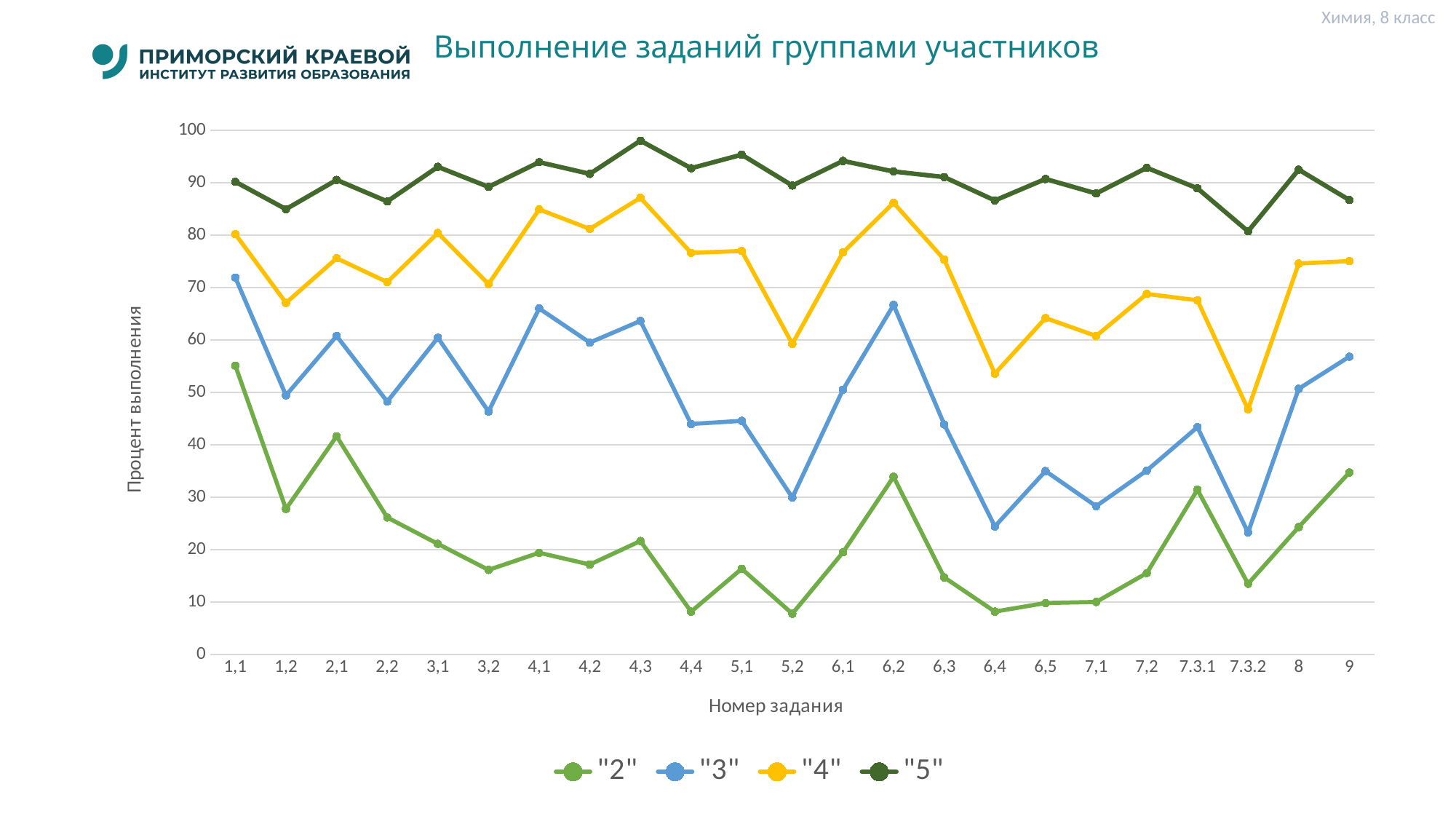
Is the value of series "2" for task 1,1 greater or less than 50? greater Is the value of series "5" for task 4,3 greater or less than 90? greater What kind of chart is shown on the slide? line chart Is the value of series "3" for task 5,2 greater or less than 40? less How many series does the legend list? 4 What is the title of the chart? Выполнение заданий группами участников For which task number does the series "2" reach its highest value? 1,1 For which task number does the series "3" reach its highest value? 1,1 For which task number does the series "5" reach its highest value? 4,3 For task 6,2, which series has the larger value: "4" or "3"? "4" How many task numbers are shown along the x axis? 23 For which task number does the series "4" reach its lowest value? 7.3.2